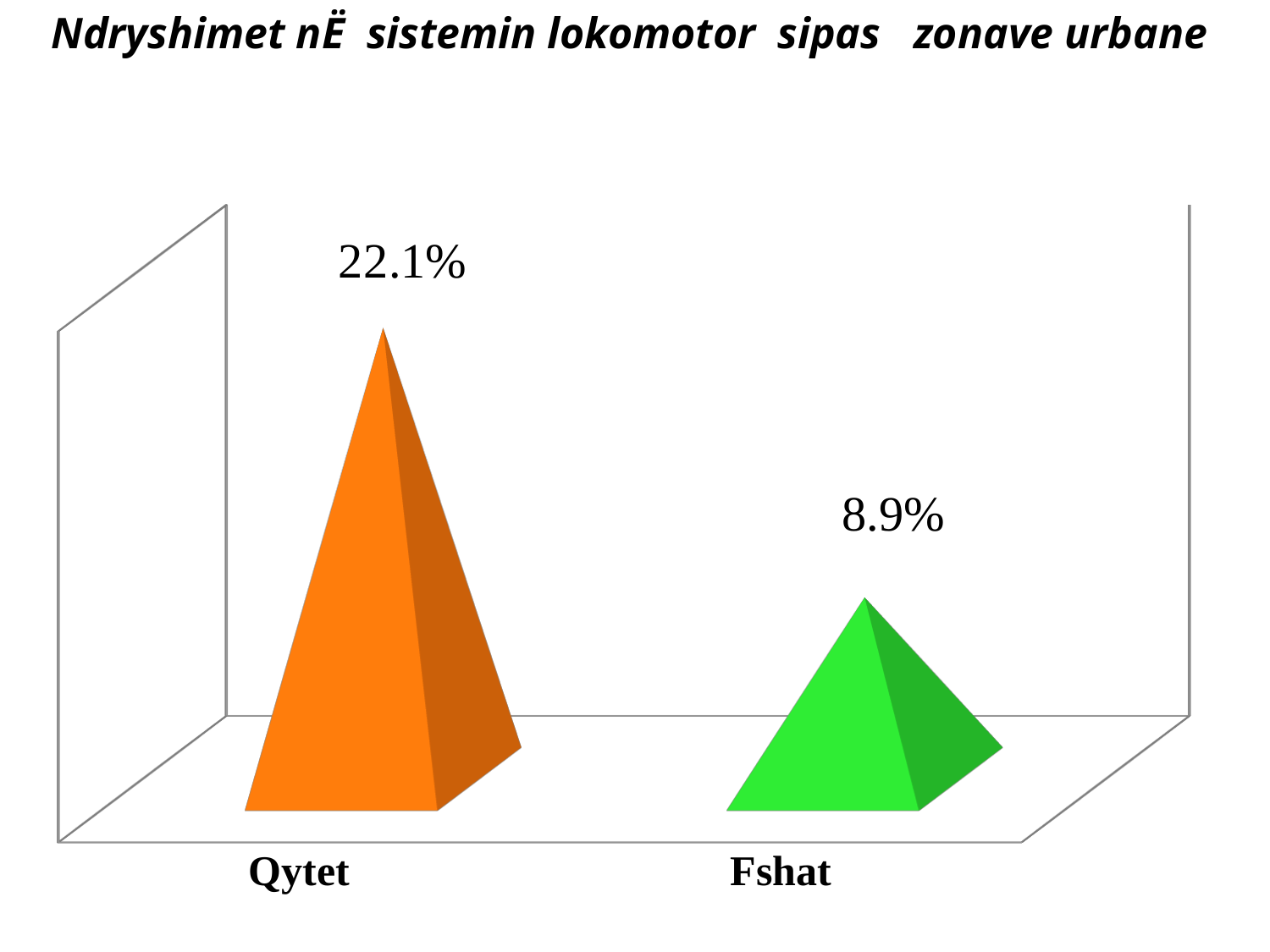
Do the values rise or fall from Qytet to Fshat? fall Which is larger, the value for Qytet or the value for Fshat? Qytet What is the value for Qytet? 22.1% What kind of chart is shown on the slide? bar chart Which category has the lowest value? Fshat What colour is the bar for Fshat? green What is the title of the chart? Ndryshimet nË sistemin lokomotor sipas zonave urbane Which category has the highest value? Qytet What is the value for Fshat? 8.9% What is the difference between the values for Qytet and Fshat? 13.2% How many categories are shown on the chart? 2